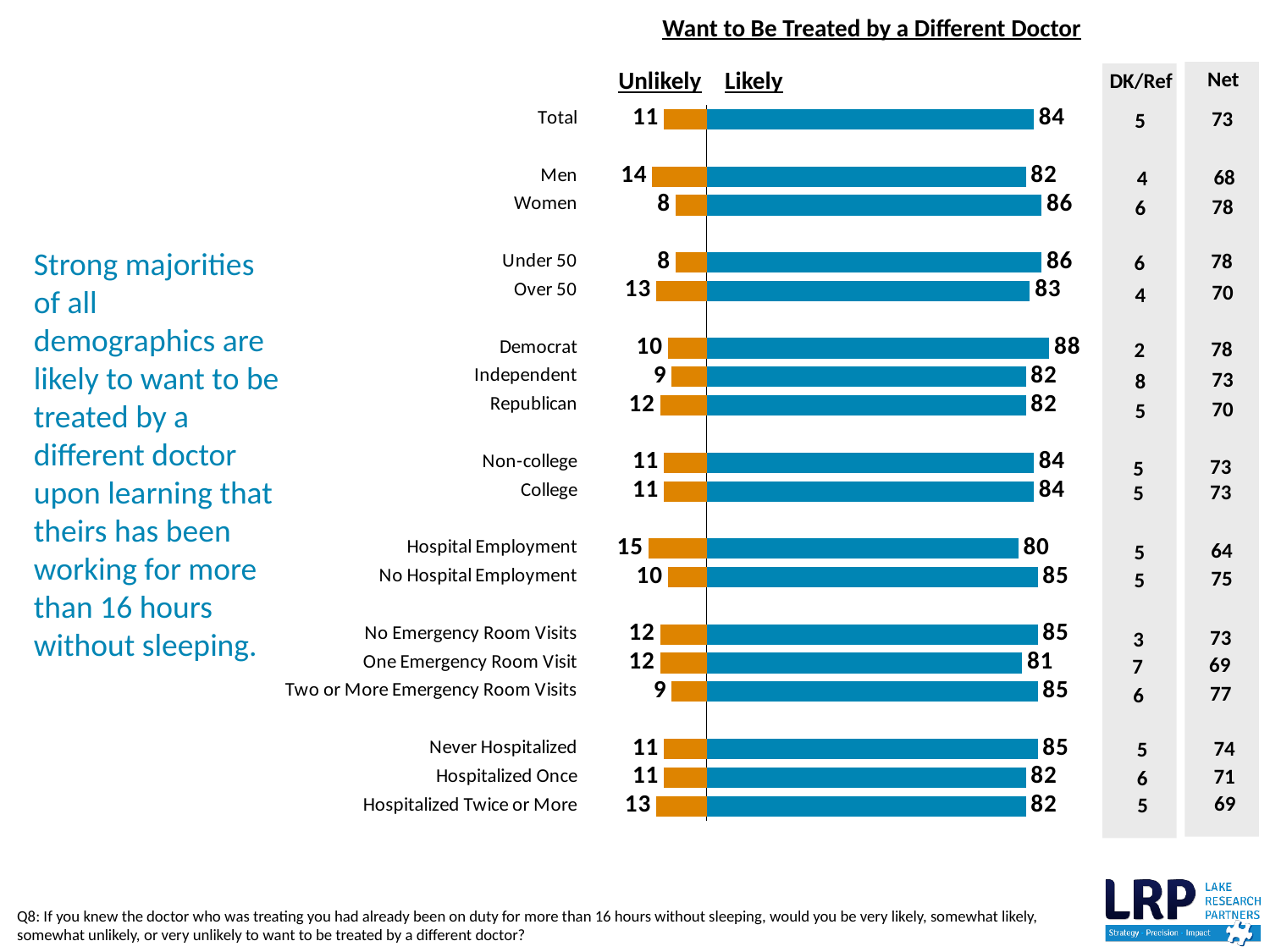
Which category has the highest Likely value? Democrat How many categories are plotted in the chart? 18 Which has a larger Unlikely value, Men or Women? Men What is the Likely value for Total? 84 What is the Likely value for Democrat? 88 Which category has the lowest Likely value? Hospital Employment What is the difference between the Likely values for Women and Men? 4 What kind of chart is shown on the slide? Bar chart How many series does the chart show? 2 What is the Unlikely value for Hospital Employment? 15 What is the title of the chart? Want to Be Treated by a Different Doctor Which category has the highest Unlikely value? Hospital Employment